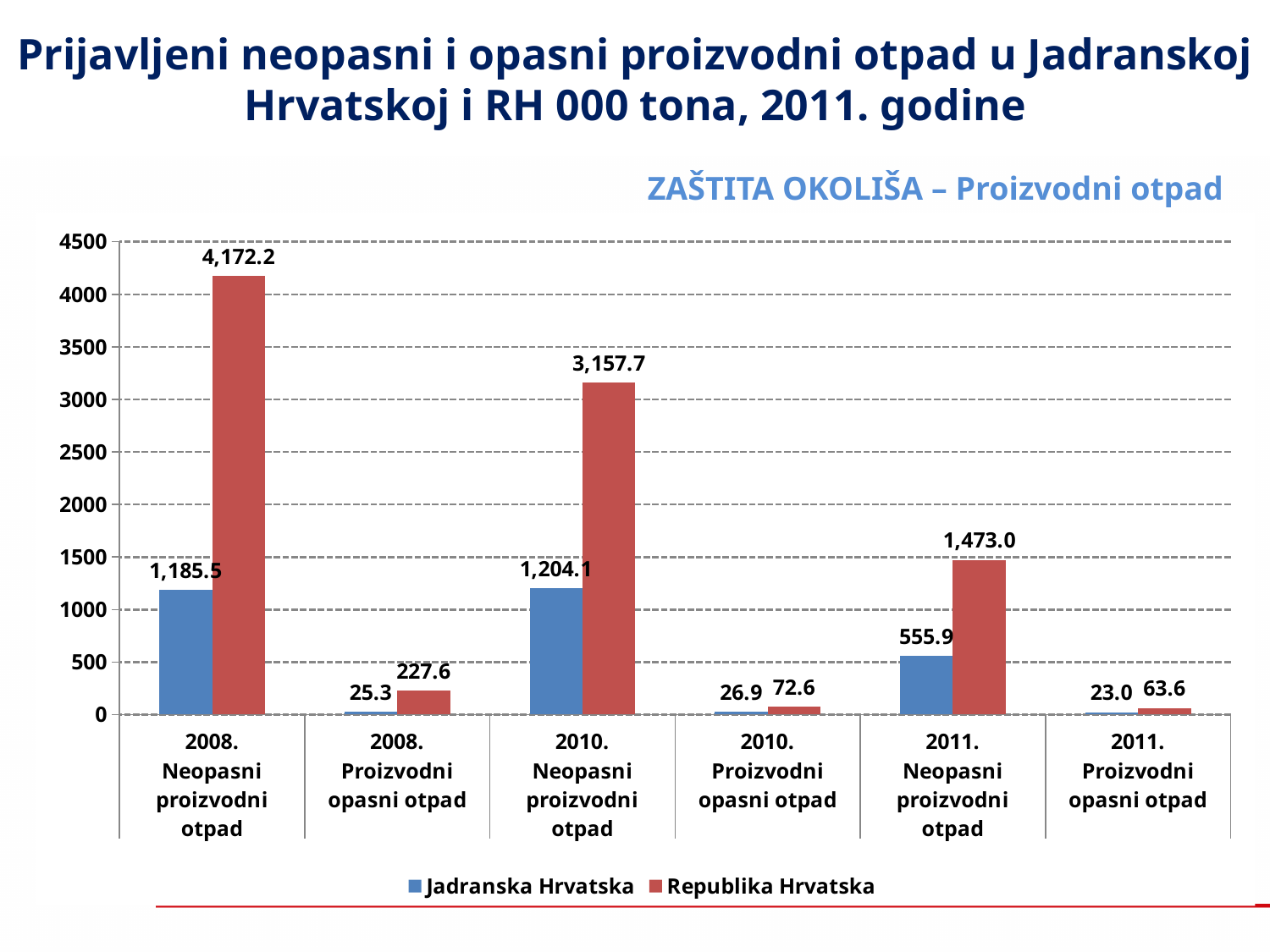
How many categories are shown on the x axis of the chart? 6 Is the value for Republika Hrvatska in "2010. Neopasni proizvodni otpad" greater or less than 3000? greater In which category does Jadranska Hrvatska have its lowest value? 2011. Proizvodni opasni otpad What is the value for Jadranska Hrvatska in the category "2010. Proizvodni opasni otpad"? 26.9 What is the difference between Republika Hrvatska and Jadranska Hrvatska in the category "2008. Proizvodni opasni otpad"? 202.3 What kind of chart is shown on the slide? bar chart How many series does the legend list? 2 Which is larger for Jadranska Hrvatska: the value for "2008. Neopasni proizvodni otpad" or for "2010. Neopasni proizvodni otpad"? 2010. Neopasni proizvodni otpad What is the difference between Republika Hrvatska and Jadranska Hrvatska in the category "2011. Neopasni proizvodni otpad"? 917.1 What is the value for Jadranska Hrvatska in the category "2011. Neopasni proizvodni otpad"? 555.9 In which category does Republika Hrvatska have its highest value? 2008. Neopasni proizvodni otpad What is the value for Republika Hrvatska in the category "2008. Neopasni proizvodni otpad"? 4,172.2